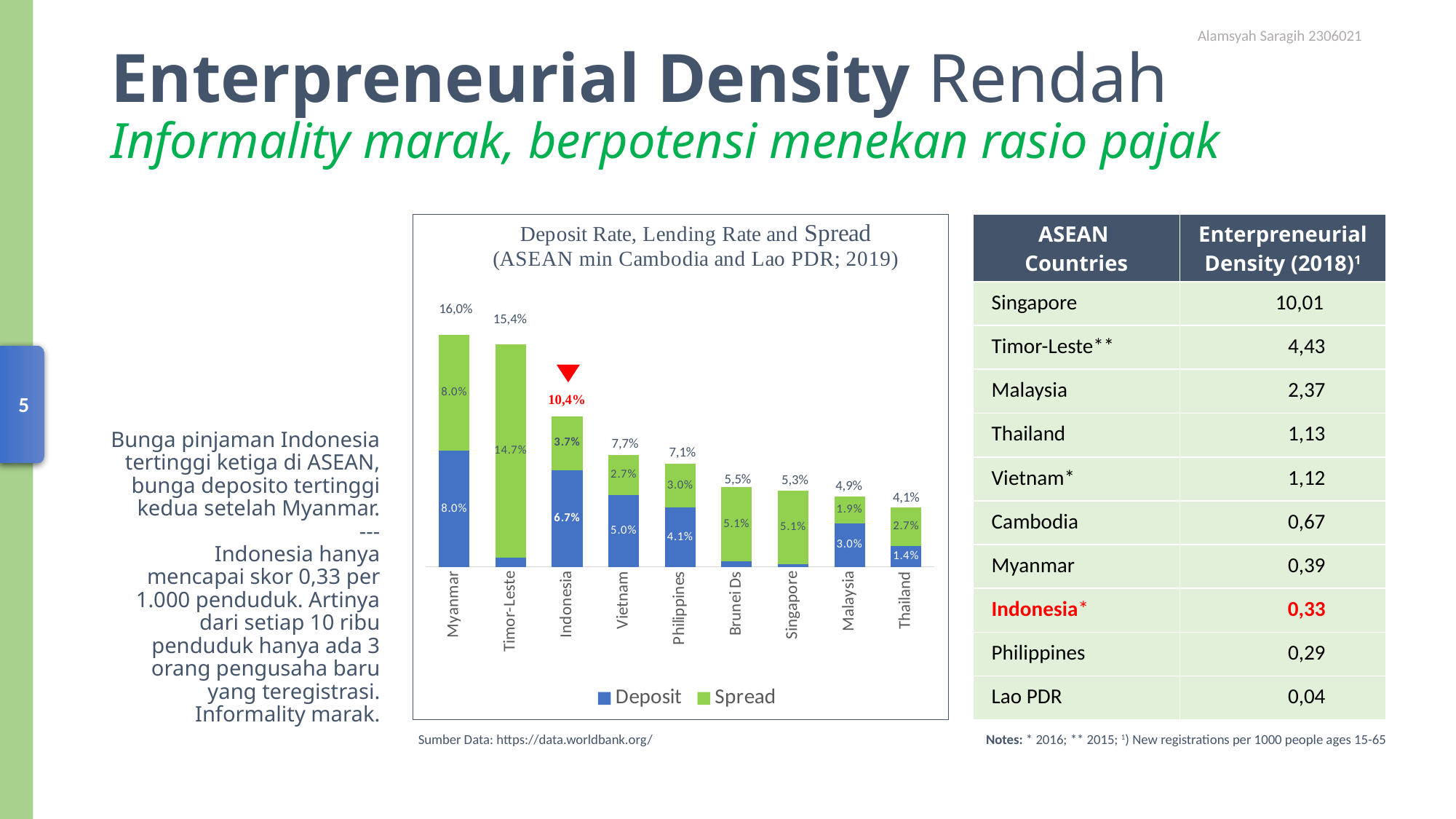
Which country has the lowest total in the chart? Thailand How many countries are shown on the x axis of the chart? 9 Do the total values rise or fall moving from left to right along the x axis? Fall What is the Spread value for Timor-Leste? 14.7% Which country has the largest Spread segment? Timor-Leste Which country has the highest total (deposit plus spread) in the chart? Myanmar What is the difference between the totals for Myanmar and Timor-Leste? 0,6% What kind of chart is shown on the slide? Stacked bar chart How many series does the chart legend list? 2 Which has the larger total, Vietnam or Philippines? Vietnam What is the total labeled above the Myanmar bar? 16,0% What is the Deposit value for Indonesia? 6.7%